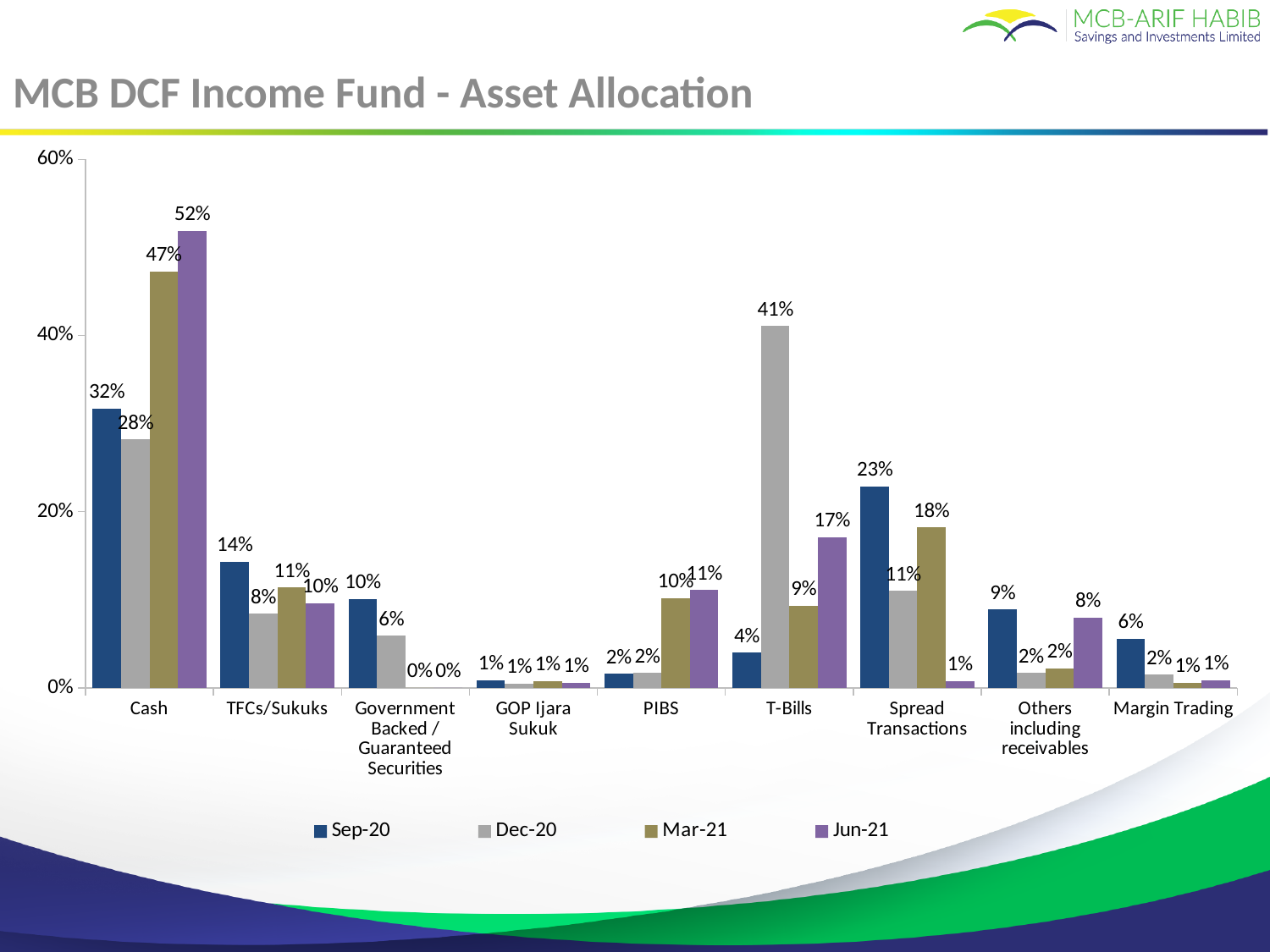
What is the Dec-20 value for T-Bills? 41% Which category has the lowest Jun-21 value? Government Backed / Guaranteed Securities What is the Mar-21 value for PIBS? 10% How many series does the legend list? 4 What is the Sep-20 value for Spread Transactions? 23% How many asset categories are shown on the x axis? 9 Which category has the highest Sep-20 value? Cash Which is larger for T-Bills: the Dec-20 value or the Jun-21 value? Dec-20 What is the difference between the Jun-21 and Sep-20 values for Cash? 20% What is the title of the chart? MCB DCF Income Fund - Asset Allocation What kind of chart is shown on the slide? Bar chart What is the Jun-21 value for Cash? 52%